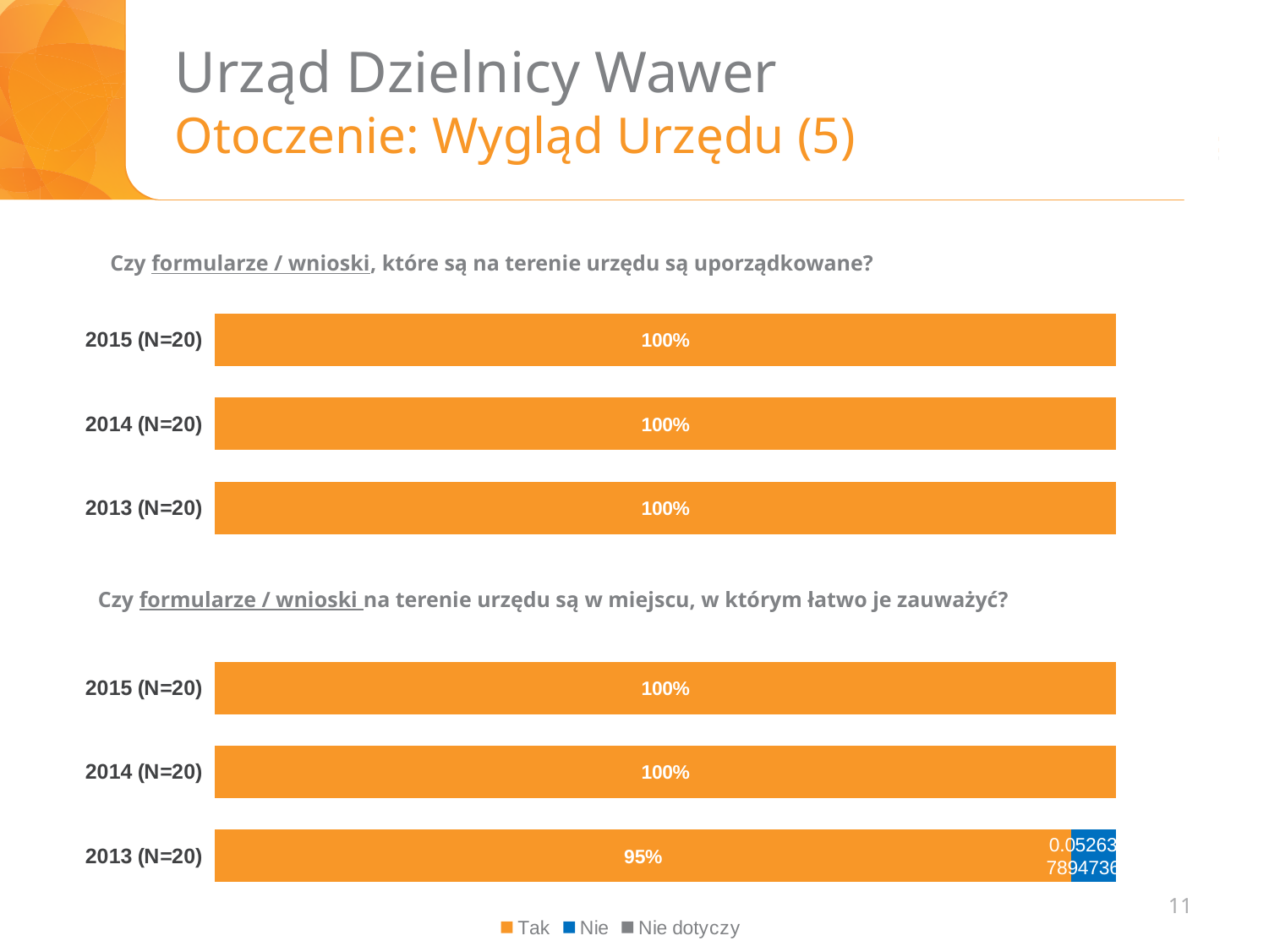
In the bottom chart, what is the 'Tak' value for 2014 (N=20)? 100% In the bottom chart, what is the 'Tak' value for 2013 (N=20)? 95% What are the three legend entries shown on the slide? Tak, Nie, Nie dotyczy In the top chart, what is the value for 2013 (N=20)? 100% In the bottom chart, is the 'Tak' value for 2014 (N=20) larger or smaller than for 2013 (N=20)? larger In the top chart, what is the value for 2015 (N=20)? 100% How many series does the legend at the bottom of the slide list? 3 In the bottom chart, which year has the lowest 'Tak' value? 2013 (N=20) What type of chart is the bottom chart? bar chart How many year categories does the top chart show? 3 In the bottom chart, which series is shown in blue for 2013 (N=20)? Nie In the bottom chart, what is the difference between the 'Tak' value for 2015 (N=20) and 2013 (N=20)? 5%